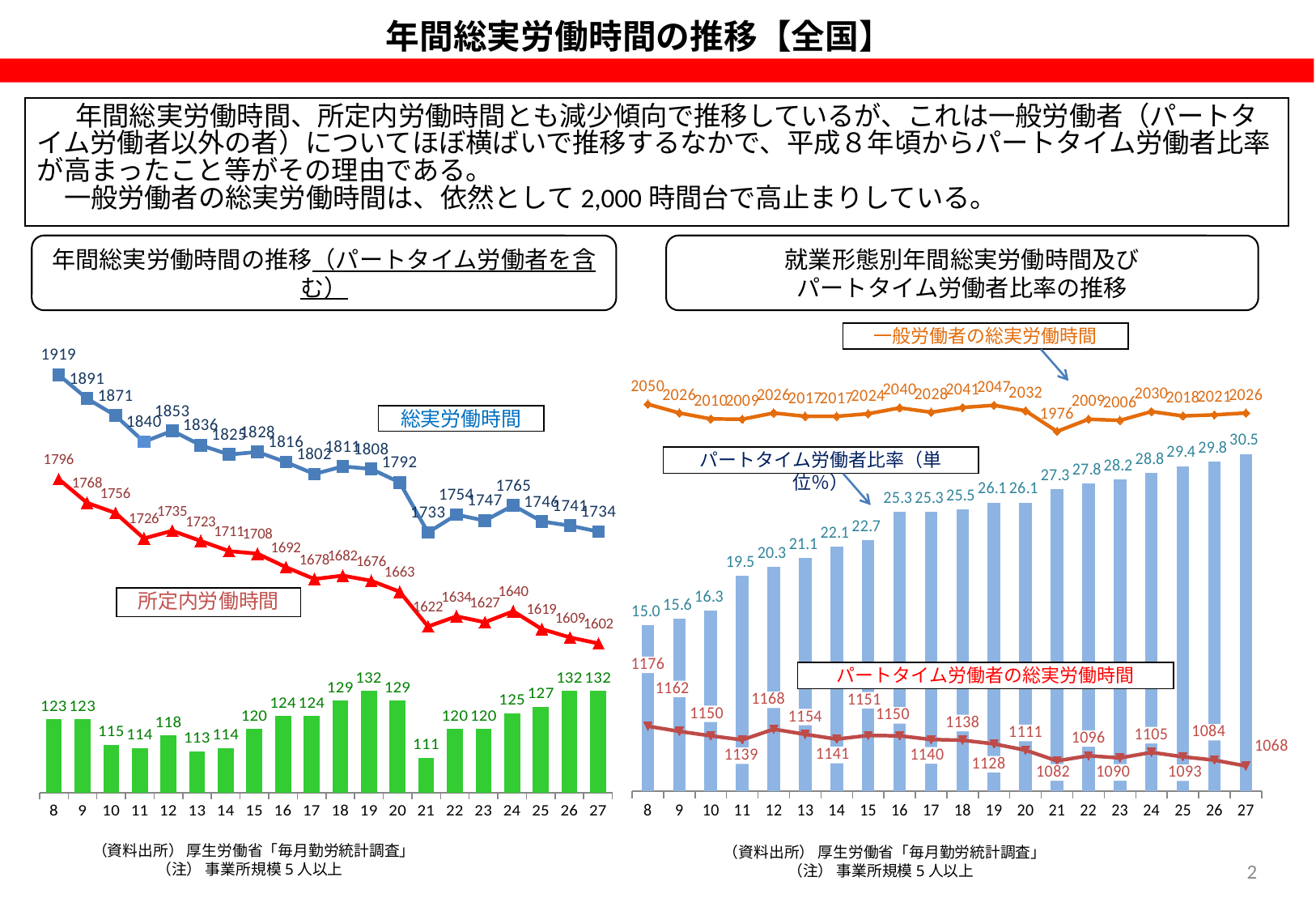
In the right chart (就業形態別年間総実労働時間及びパートタイム労働者比率の推移), which year has the highest 一般労働者の総実労働時間 value? 8 In the right chart (就業形態別年間総実労働時間及びパートタイム労働者比率の推移), which is larger: the パートタイム労働者の総実労働時間 for year 12 or for year 13? year 12 In the left chart (年間総実労働時間の推移), what is the 所定内労働時間 value for year 27? 1602 In the left chart (年間総実労働時間の推移), what is the 総実労働時間 value for year 8? 1919 In the left chart (年間総実労働時間の推移), what is the difference between the 総実労働時間 and 所定内労働時間 values for year 21? 111 In the right chart (就業形態別年間総実労働時間及びパートタイム労働者比率の推移), what is the 一般労働者の総実労働時間 value for year 21? 1976 In the left chart (年間総実労働時間の推移), does the 総実労働時間 line generally rise or fall from year 8 to year 27? fall In the right chart (就業形態別年間総実労働時間及びパートタイム労働者比率の推移), what is the パートタイム労働者比率 for year 27? 30.5 In the left chart (年間総実労働時間の推移), what is the value of the green bar for year 19? 132 In the right chart (就業形態別年間総実労働時間及びパートタイム労働者比率の推移), what is the difference between the パートタイム労働者の総実労働時間 values for year 8 and year 27? 108 In the left chart (年間総実労働時間の推移), which year has the lowest 総実労働時間 value? 21 In the right chart (就業形態別年間総実労働時間及びパートタイム労働者比率の推移), how many years are shown on the x axis? 20